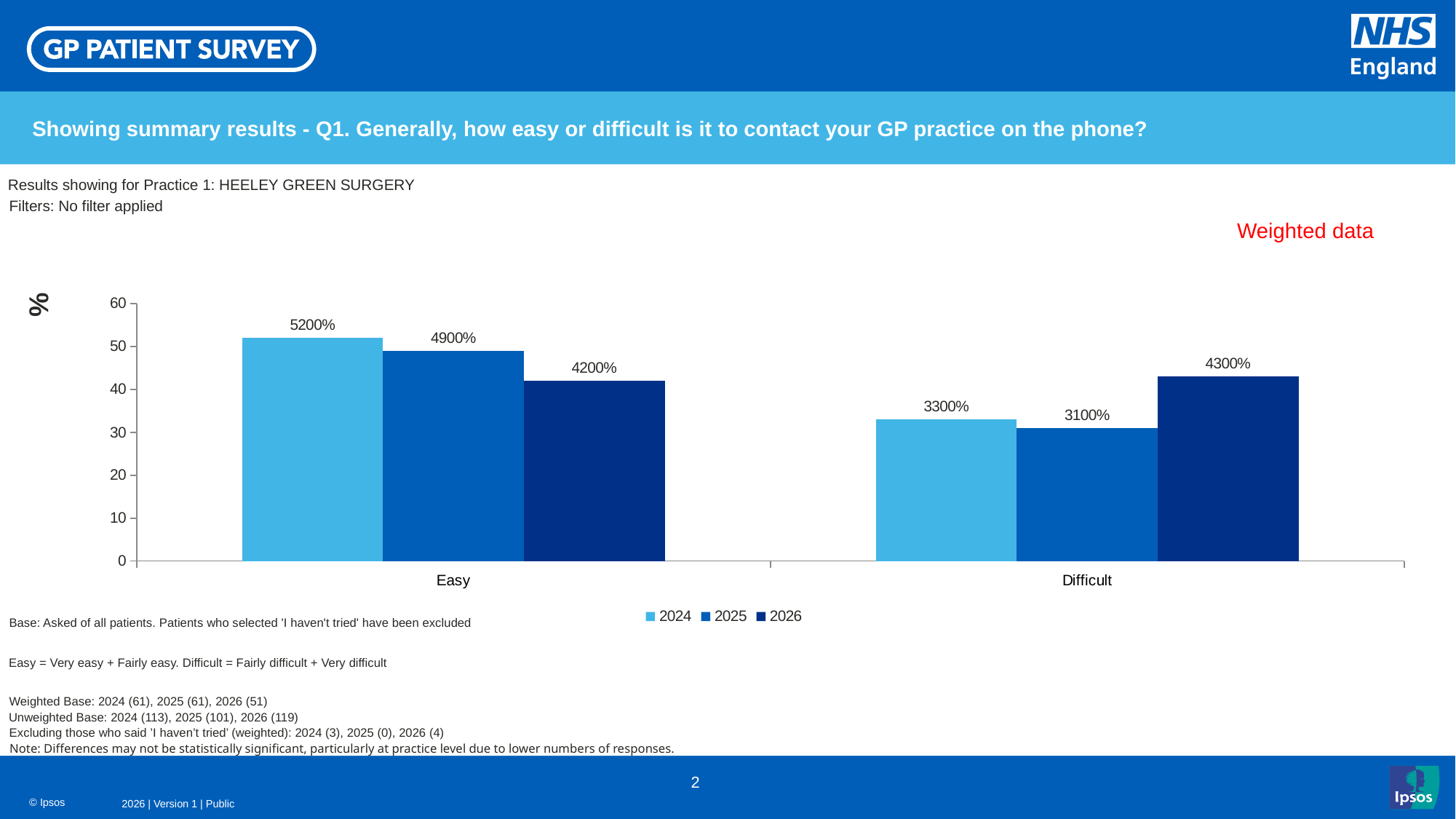
Which year has the lowest value in the Difficult category? 2025 How many series does the legend list? 3 Do the values in the Easy category rise or fall from 2024 to 2026? Fall What is the value for 2026 in the Difficult category? 4300% Which is larger: the 2026 value for Easy or the 2026 value for Difficult? 2026 value for Difficult How many categories are shown on the x axis? 2 What is the difference between the 2024 and 2026 values in the Easy category? 1000% What is the value for 2025 in the Easy category? 4900% Which year has the highest value in the Easy category? 2024 What is the value for 2024 in the Easy category? 5200% What is the value for 2025 in the Difficult category? 3100% What kind of chart is shown on the slide? Bar chart